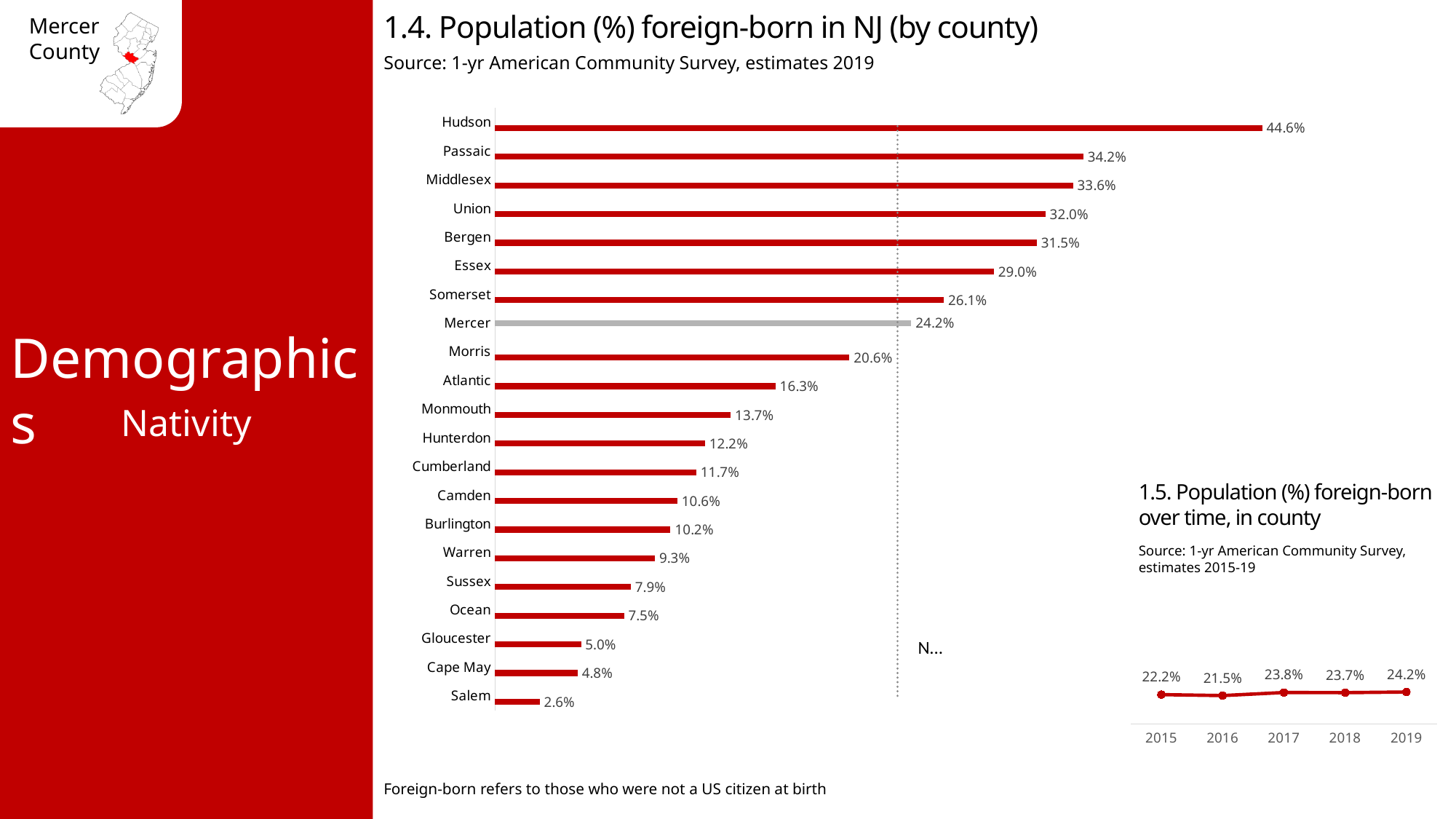
In the chart '1.4. Population (%) foreign-born in NJ (by county)', what is the value for Essex? 29.0% How many counties are shown in the chart '1.4. Population (%) foreign-born in NJ (by county)'? 21 In the chart '1.4. Population (%) foreign-born in NJ (by county)', which county has the highest value? Hudson In the chart '1.5. Population (%) foreign-born over time, in county', what is the value for 2017? 23.8% In the chart '1.4. Population (%) foreign-born in NJ (by county)', what is the difference between Hudson and Passaic? 10.4% In the chart '1.4. Population (%) foreign-born in NJ (by county)', what is the value for Mercer? 24.2% In the chart '1.5. Population (%) foreign-born over time, in county', which year has the lowest value? 2016 In the chart '1.5. Population (%) foreign-born over time, in county', what is the difference between 2019 and 2015? 2.0% What kind of chart is '1.5. Population (%) foreign-born over time, in county'? Line chart In the chart '1.4. Population (%) foreign-born in NJ (by county)', which is larger, Camden or Burlington? Camden In the chart '1.4. Population (%) foreign-born in NJ (by county)', which county has the lowest value? Salem What kind of chart is '1.4. Population (%) foreign-born in NJ (by county)'? Bar chart